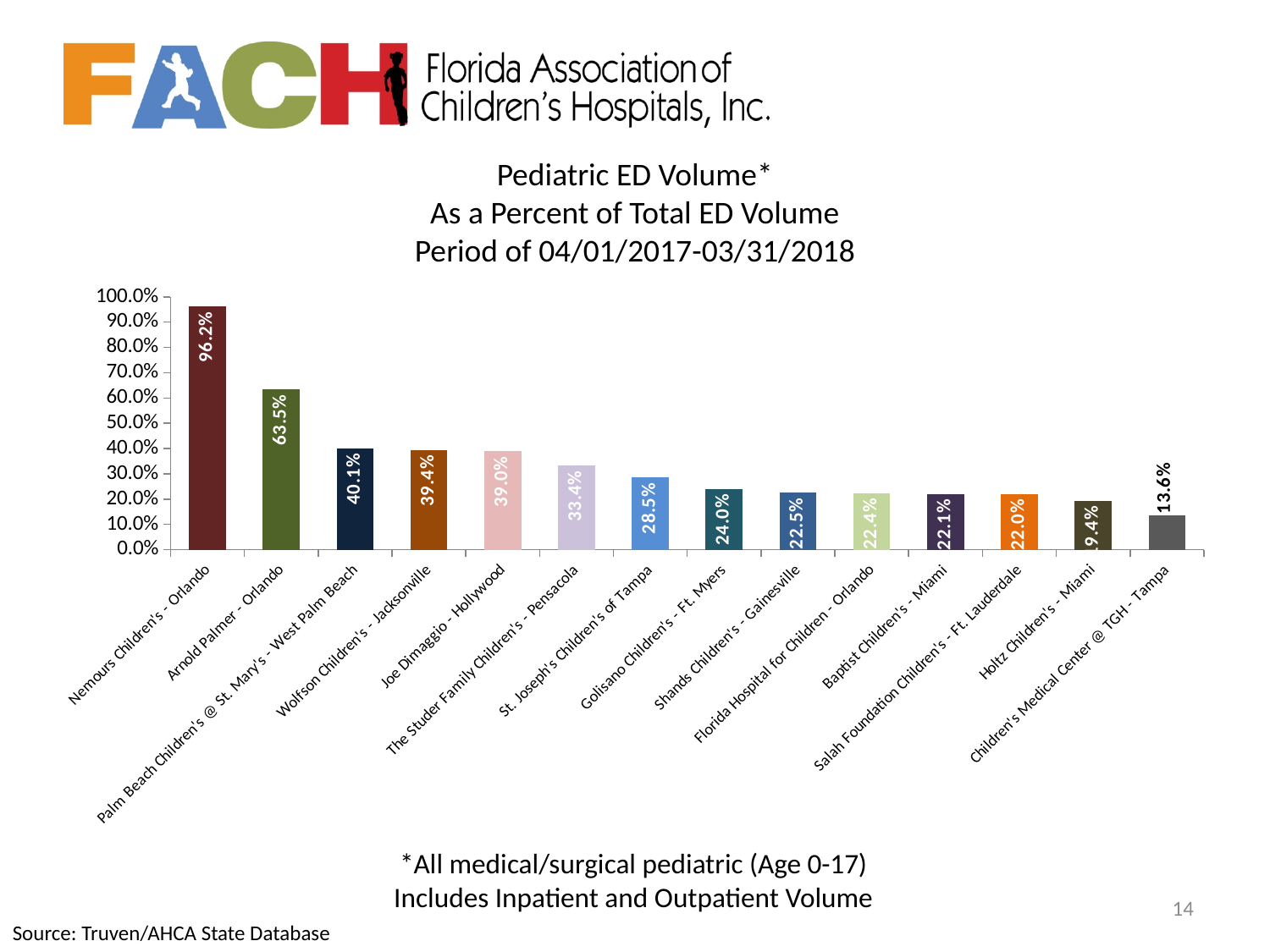
Which hospital has the lowest pediatric ED volume as a percent of total ED volume? Children's Medical Center @ TGH - Tampa What is the value for Children's Medical Center @ TGH - Tampa? 13.6% What is the value for Golisano Children's - Ft. Myers? 24.0% What is the value for Nemours Children's - Orlando? 96.2% What is the difference between the values for Nemours Children's - Orlando and Arnold Palmer - Orlando? 32.7% Which is larger, the value for St. Joseph's Children's of Tampa or the value for The Studer Family Children's - Pensacola? The Studer Family Children's - Pensacola What is the value for Arnold Palmer - Orlando? 63.5% What is the value for Wolfson Children's - Jacksonville? 39.4% Is the value for Holtz Children's - Miami greater or less than 30.0%? less How many hospitals are shown in the chart? 14 What kind of chart is shown on the slide? Bar chart Which hospital has the highest pediatric ED volume as a percent of total ED volume? Nemours Children's - Orlando